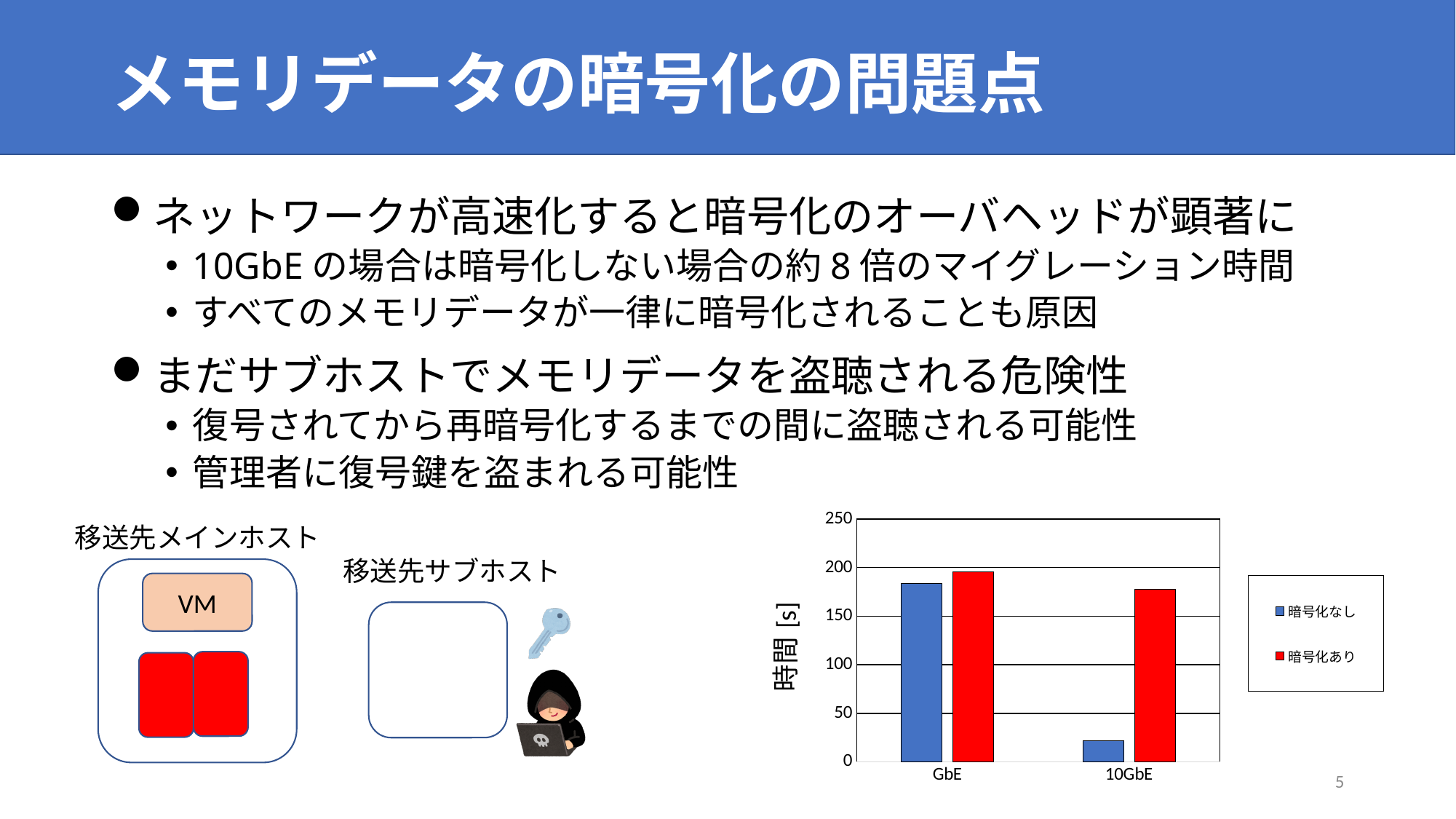
Which category has the lowest bar in the chart? 10GbE (暗号化なし) What is the y-axis label of the chart? 時間 [s] What are the two series named in the chart legend? 暗号化なし and 暗号化あり How many series does the chart legend list? 2 For 10GbE, which is larger: 暗号化なし or 暗号化あり? 暗号化あり What kind of chart is shown at the bottom right of the slide? bar chart How many categories are shown on the x axis of the chart? 2 Is the value for 暗号化なし at 10GbE greater or less than 50? less Is the value for 暗号化あり at 10GbE greater or less than 150? greater Does the 暗号化なし series rise or fall from GbE to 10GbE? fall Is the value for 暗号化あり at GbE greater or less than 100? greater